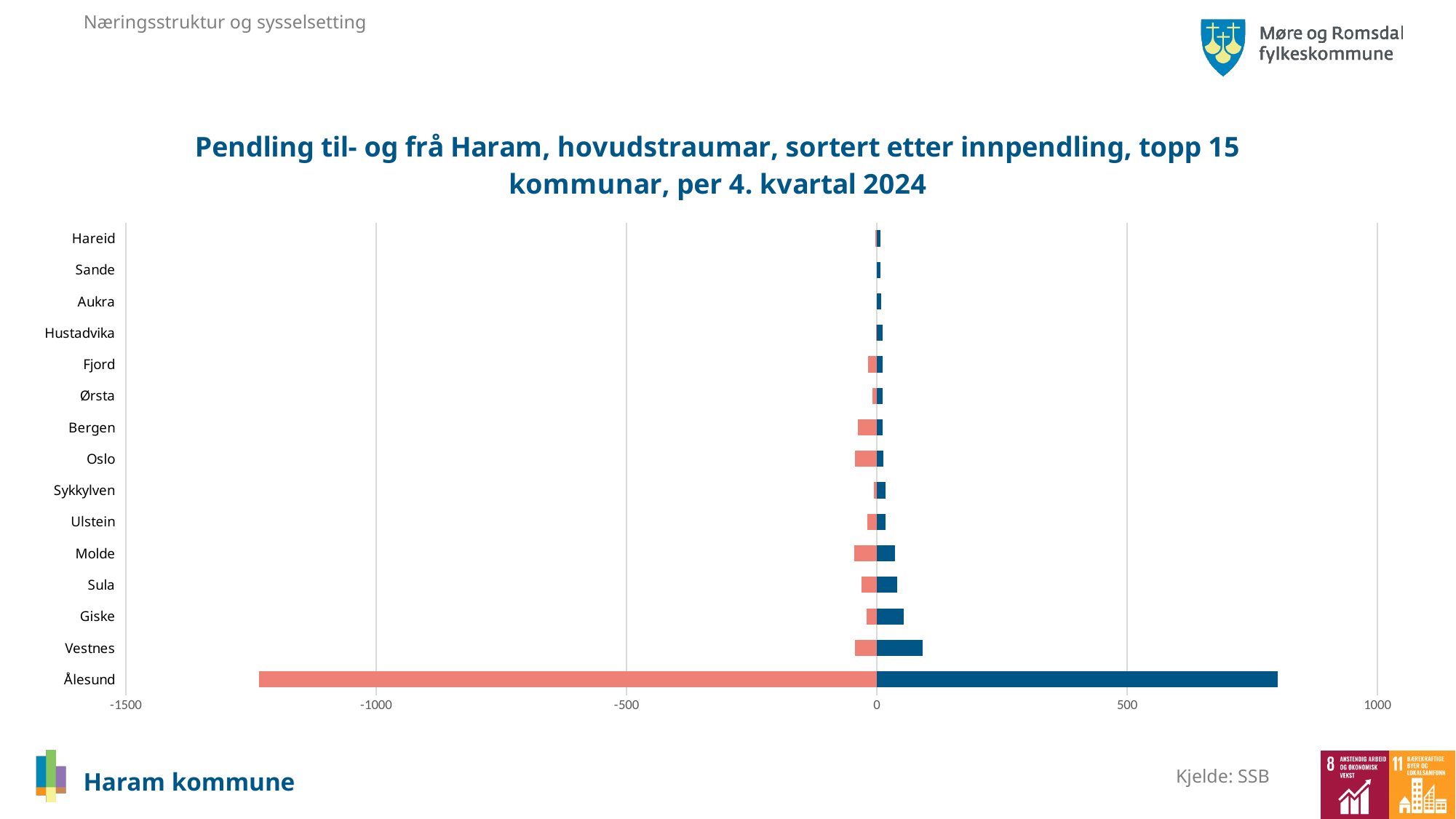
What kind of chart is shown on the slide? bar chart Which municipality has the longest red (negative) bar in the chart? Ålesund What is the title of the chart? Pendling til- og frå Haram, hovudstraumar, sortert etter innpendling, topp 15 kommunar, per 4. kvartal 2024 Which has the longer red bar, Bergen or Hareid? Bergen How many municipalities (categories) are listed on the vertical axis of the chart? 15 Which municipality is listed at the top of the vertical axis? Hareid What is the lowest value shown on the horizontal axis? -1500 Is the red bar for Ålesund greater or less than -1000? less Is the blue bar for Vestnes greater or less than 500? less Which has the longer blue bar, Vestnes or Giske? Vestnes Which municipality has the longest blue (positive) bar in the chart? Ålesund Is the blue bar for Ålesund greater or less than 500? greater